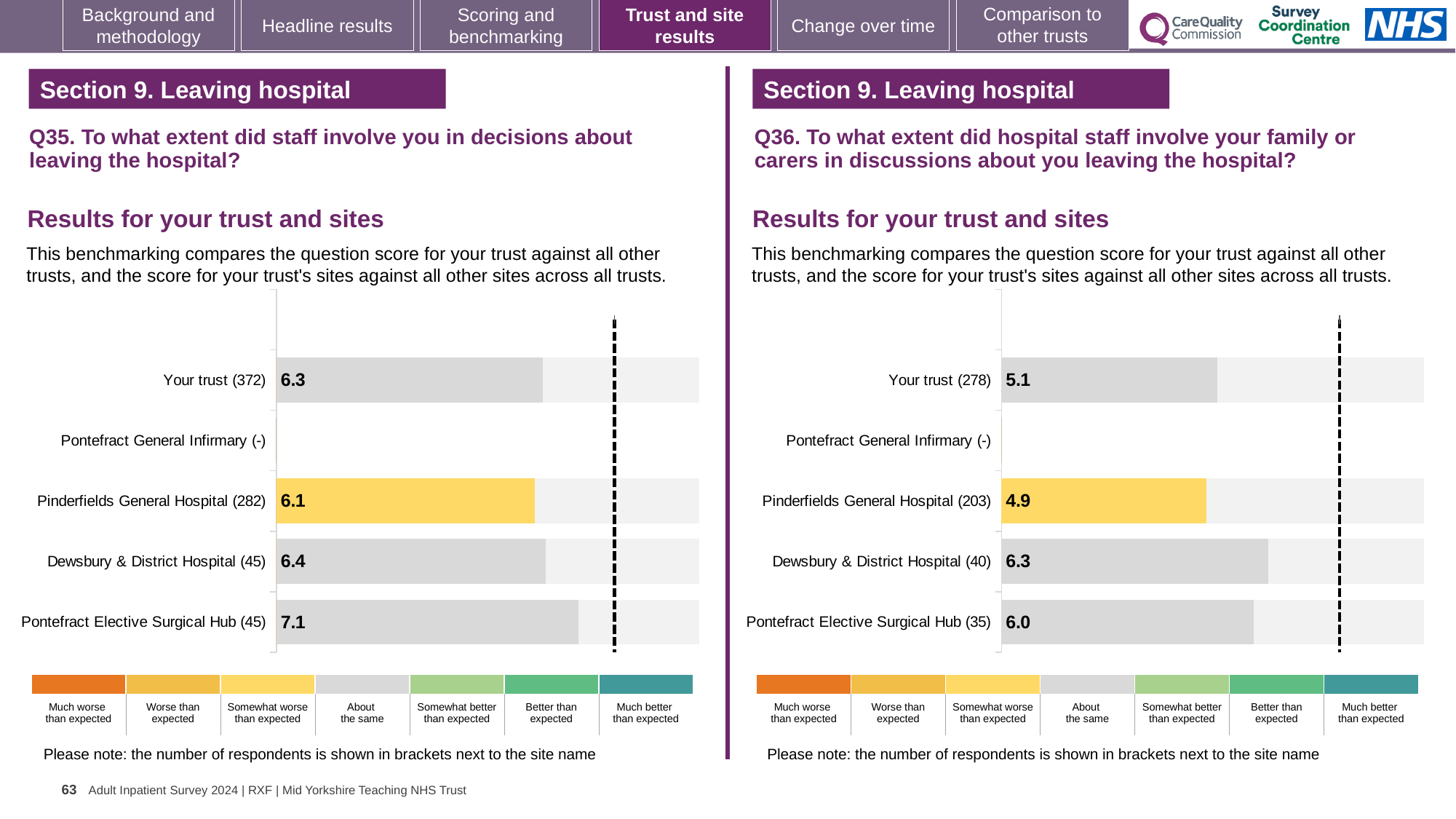
In the Q36 chart on the right, which has the higher score: Dewsbury & District Hospital (40) or Pontefract Elective Surgical Hub (35)? Dewsbury & District Hospital (40) In the Q35 chart on the left, what is the difference between the scores for Pontefract Elective Surgical Hub (45) and Pinderfields General Hospital (282)? 1.0 In the Q36 chart on the right, what is the score for Dewsbury & District Hospital (40)? 6.3 In the Q35 chart on the left, which site has the highest score? Pontefract Elective Surgical Hub (45) In the Q35 chart on the left, which has the higher score: Your trust (372) or Dewsbury & District Hospital (45)? Dewsbury & District Hospital (45) What type of chart is used for the Q35 results on the left? Bar chart In the Q35 chart on the left, which benchmark category does the yellow colour of the Pinderfields General Hospital bar represent according to the legend? Somewhat worse than expected In the Q36 chart on the right, which site has the lowest score? Pinderfields General Hospital (203) In the Q35 chart on the left, what is the score for Your trust (372)? 6.3 In the Q36 chart on the right, what is the score for Pinderfields General Hospital (203)? 4.9 How many rows (trust and sites) are listed in the Q36 chart on the right? 5 In the Q36 chart on the right, what is the difference between the scores for Dewsbury & District Hospital (40) and Your trust (278)? 1.2